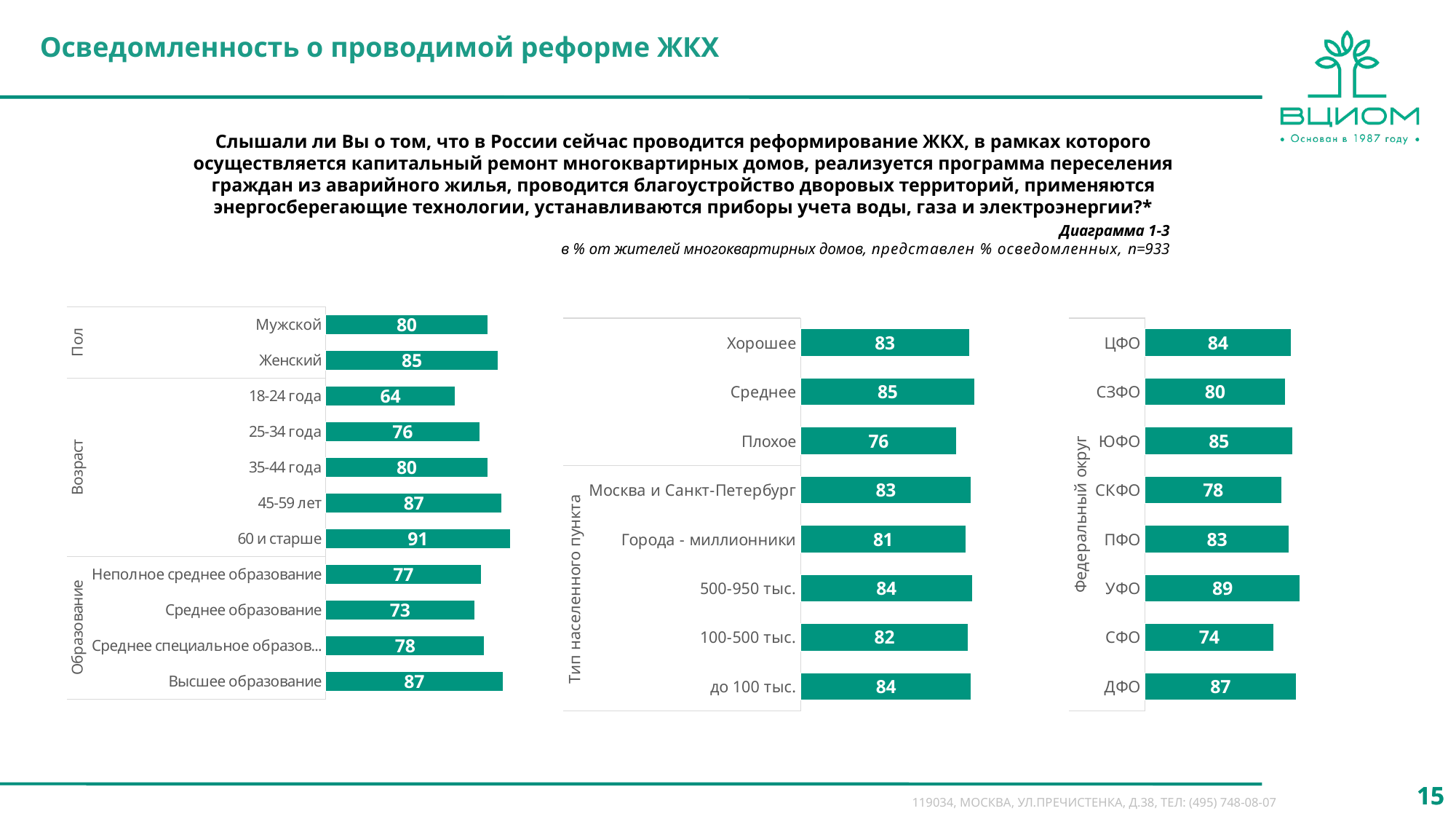
In the left chart, what is the value for Женский? 85 In the left chart, what is the value for 60 и старше? 91 In the right chart (Федеральный округ), what is the difference between ДФО and СКФО? 9 In the right chart (Федеральный округ), which federal district has the highest value? УФО In the left chart, does the value rise or fall as age groups go from 18-24 года to 60 и старше? rise In the right chart (Федеральный округ), which federal district has the lowest value? СФО In the middle chart, how many categories are plotted? 8 What type of chart is used on this slide? bar chart In the left chart, which age group has the lowest value? 18-24 года In the middle chart, what is the value for Плохое? 76 In the left chart, what is the difference between Высшее образование and Среднее образование? 14 In the middle chart, which is larger: Москва и Санкт-Петербург or Города - миллионники? Москва и Санкт-Петербург